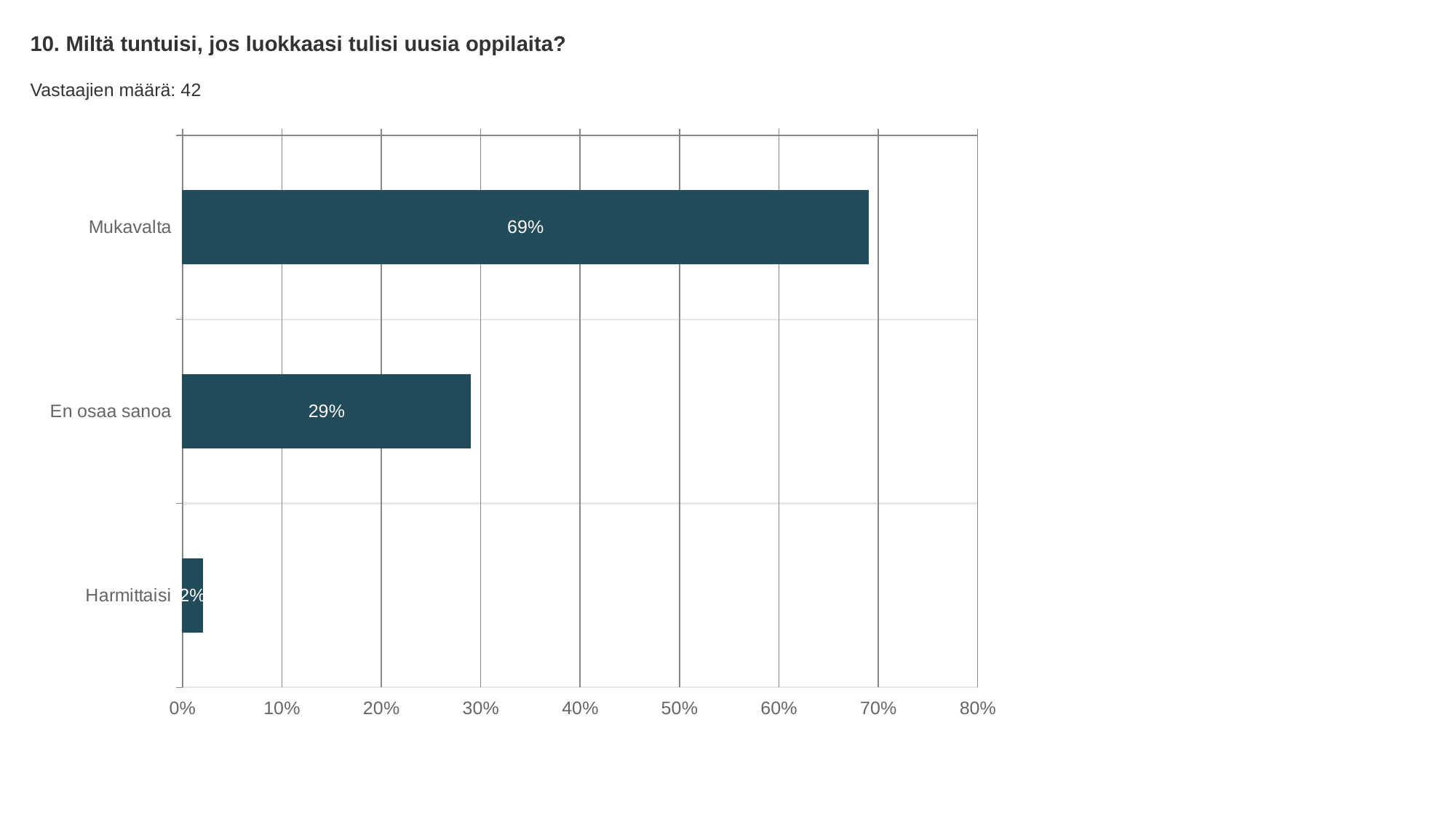
What is the value for Harmittaisi? 2% What is the difference between the values for Mukavalta and En osaa sanoa? 40% How many categories are shown in the chart? 3 What is the difference between the values for En osaa sanoa and Harmittaisi? 27% Which is larger, the value for En osaa sanoa or the value for Harmittaisi? En osaa sanoa Is the value for Mukavalta greater or less than 60%? greater How many respondents (Vastaajien määrä) does the slide report? 42 Which category has the highest value? Mukavalta What is the value for En osaa sanoa? 29% What kind of chart is shown on the slide? bar chart What is the value for Mukavalta? 69% Which category has the lowest value? Harmittaisi